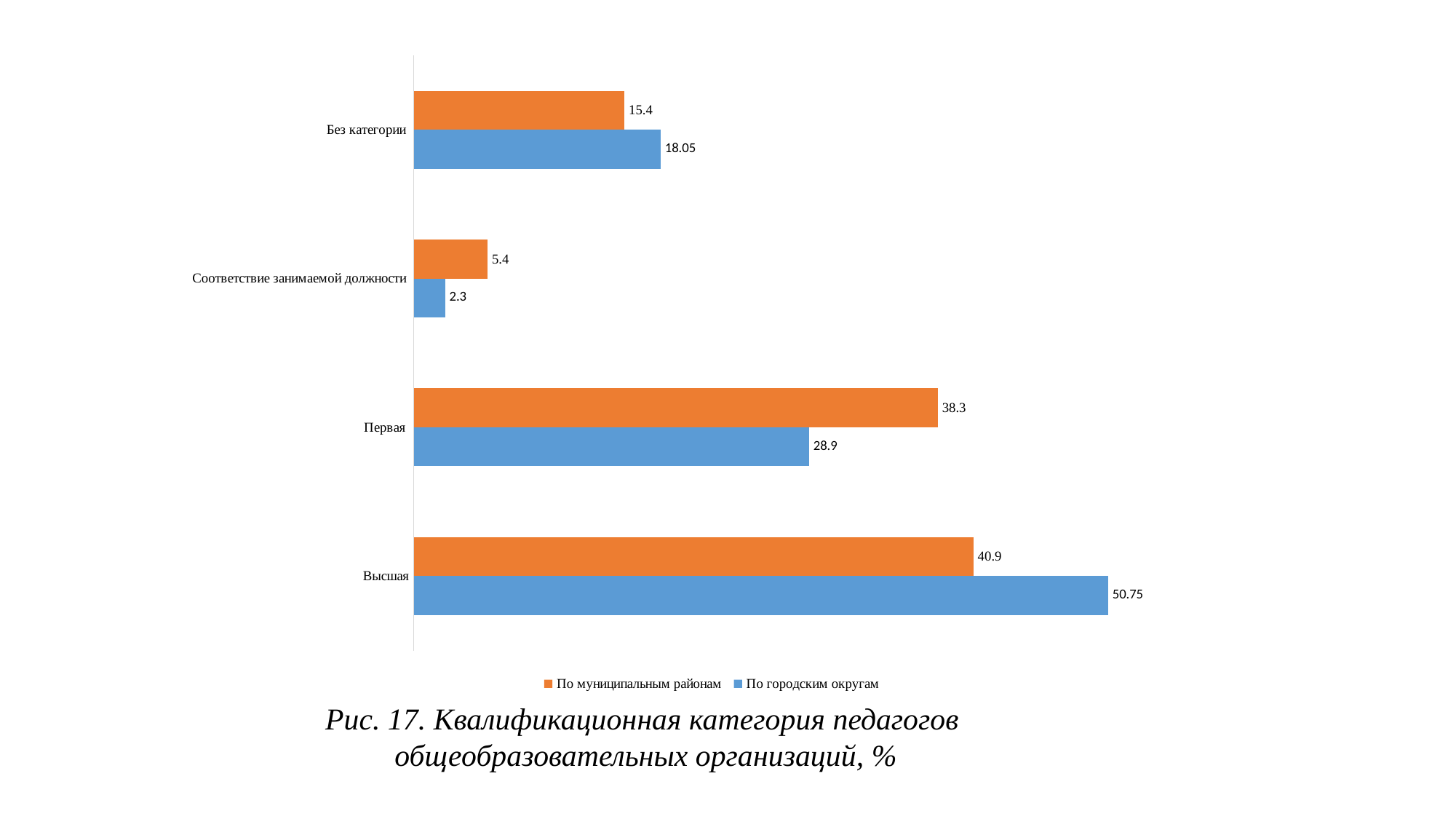
What is the difference between the 'По муниципальным районам' and 'По городским округам' values for 'Первая'? 9.4 What is the value for 'Высшая' in the 'По городским округам' series? 50.75 Which category has the lowest value in the 'По муниципальным районам' series? Соответствие занимаемой должности How many categories are shown on the chart? 4 For 'Без категории', which series has the larger value: 'По муниципальным районам' or 'По городским округам'? По городским округам What is the difference between the 'По городским округам' and 'По муниципальным районам' values for 'Высшая'? 9.85 What is the value for 'Без категории' in the 'По муниципальным районам' series? 15.4 What kind of chart is shown on the slide? Bar chart What is the value for 'Соответствие занимаемой должности' in the 'По городским округам' series? 2.3 What is the value for 'Первая' in the 'По муниципальным районам' series? 38.3 Which category has the highest value in the 'По городским округам' series? Высшая How many series does the legend list? 2